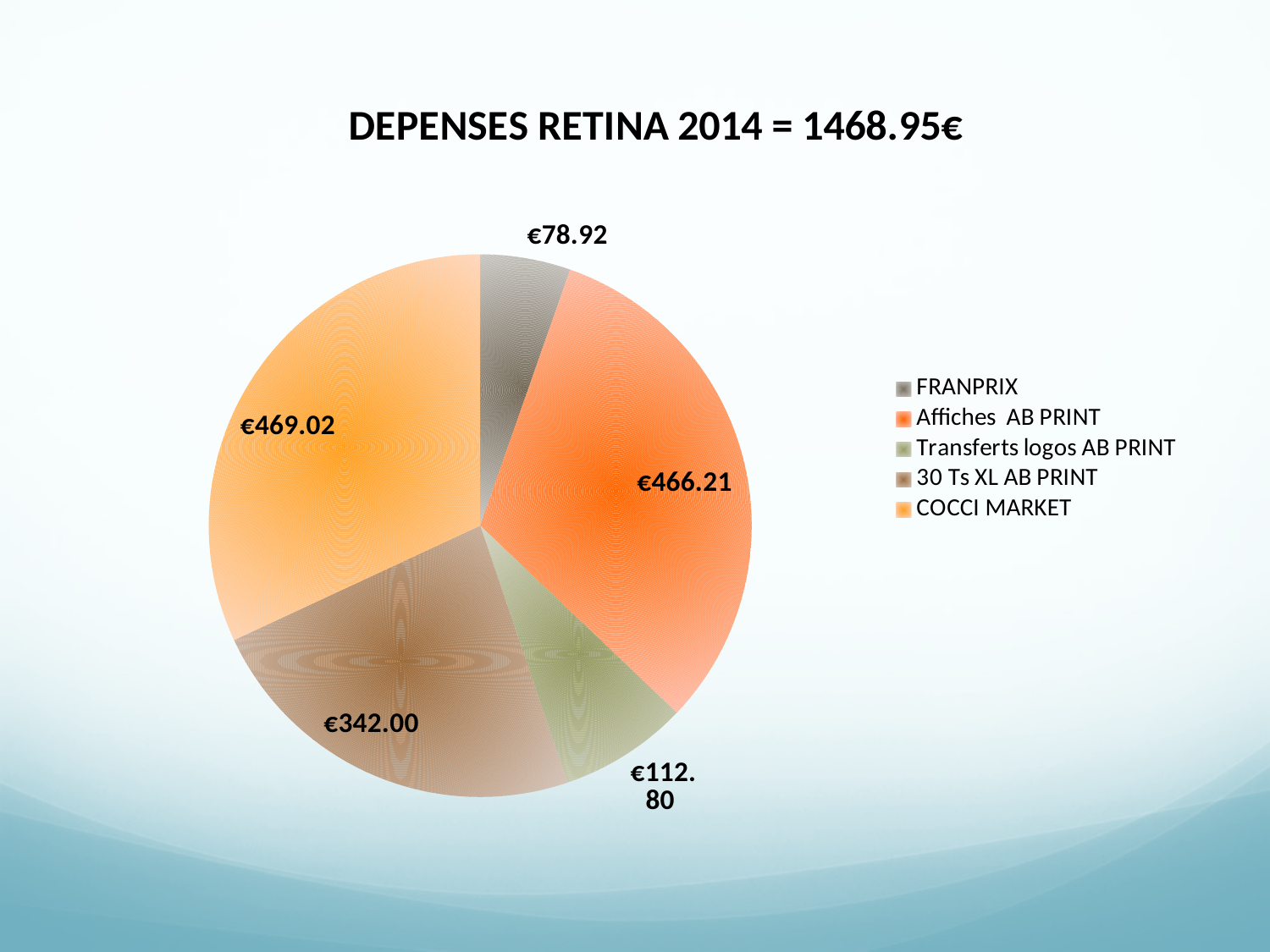
What is the difference between the Affiches AB PRINT value and the 30 Ts XL AB PRINT value? €124.21 What is the value of the Transferts logos AB PRINT slice? €112.80 What kind of chart is shown on the slide? Pie chart What is the value of the 30 Ts XL AB PRINT slice? €342.00 What is the value of the COCCI MARKET slice? €469.02 What is the title of the chart? DEPENSES RETINA 2014 = 1468.95€ Which category has the smallest slice of the pie? FRANPRIX What is the value of the FRANPRIX slice? €78.92 How many categories does the pie chart show? 5 What is the value of the Affiches AB PRINT slice? €466.21 What is the difference between the Transferts logos AB PRINT value and the FRANPRIX value? €33.88 Which is larger, the 30 Ts XL AB PRINT slice or the Transferts logos AB PRINT slice? 30 Ts XL AB PRINT